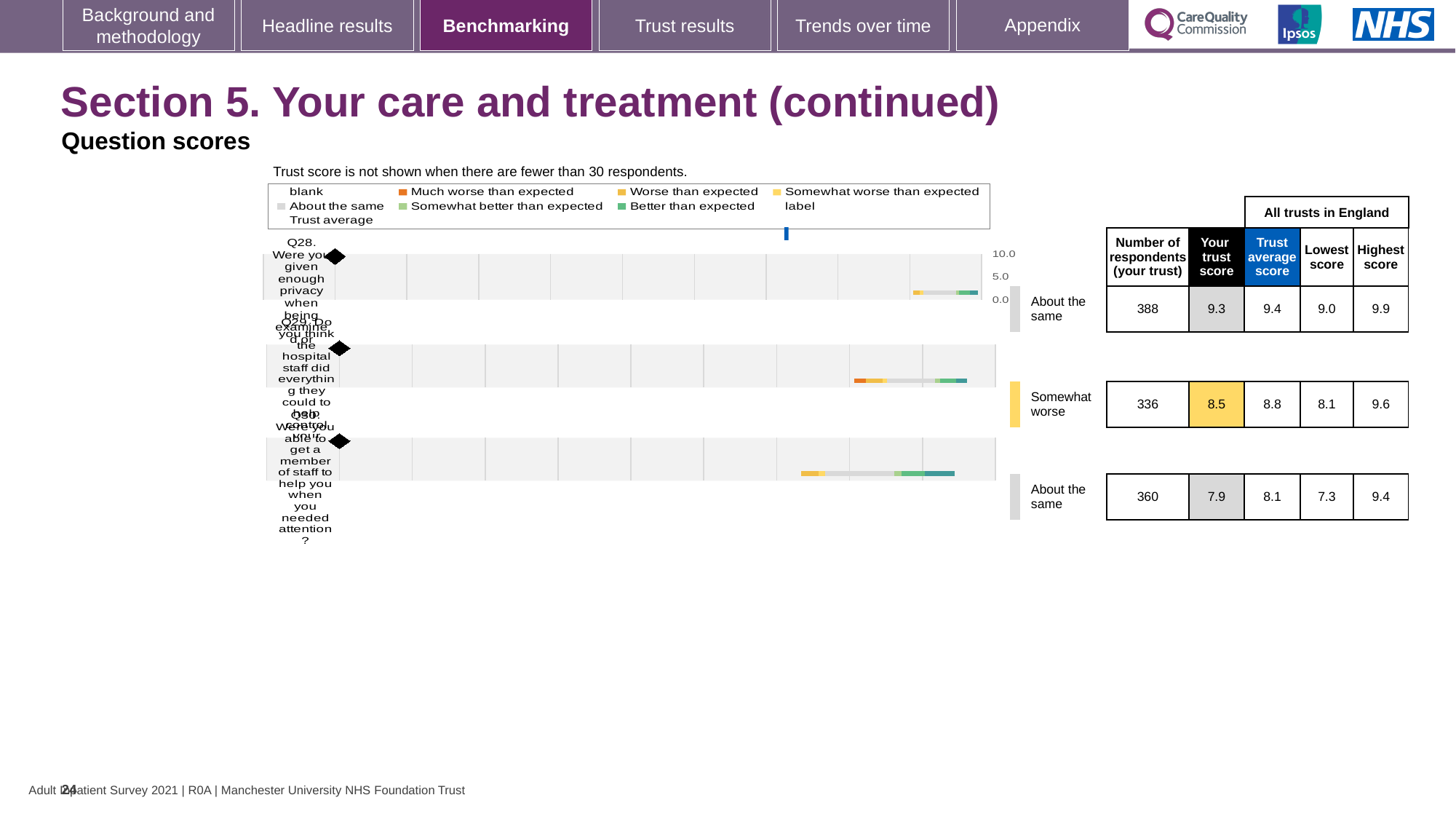
Which question has the highest trust score? Q28 What is the highest score across all trusts in England for Q30? 9.4 How many respondents answered Q29 (Do you think the hospital staff did everything they could to help control your pain)? 336 What is the trust score for Q28 (Were you given enough privacy when being examined or treated)? 9.3 What is the lowest score across all trusts in England for Q28? 9.0 Which question has the lowest trust score? Q30 How many questions are plotted on this slide? 3 For Q28, which is larger: the trust score or the trust average score? Trust average score Is the trust score for Q30 greater or less than 5.0? greater What benchmark category is shown for Q29? Somewhat worse What is the difference between the trust average score and the trust score for Q29? 0.3 What is the trust average score for Q30 (Were you able to get a member of staff to help you when you needed attention)? 8.1